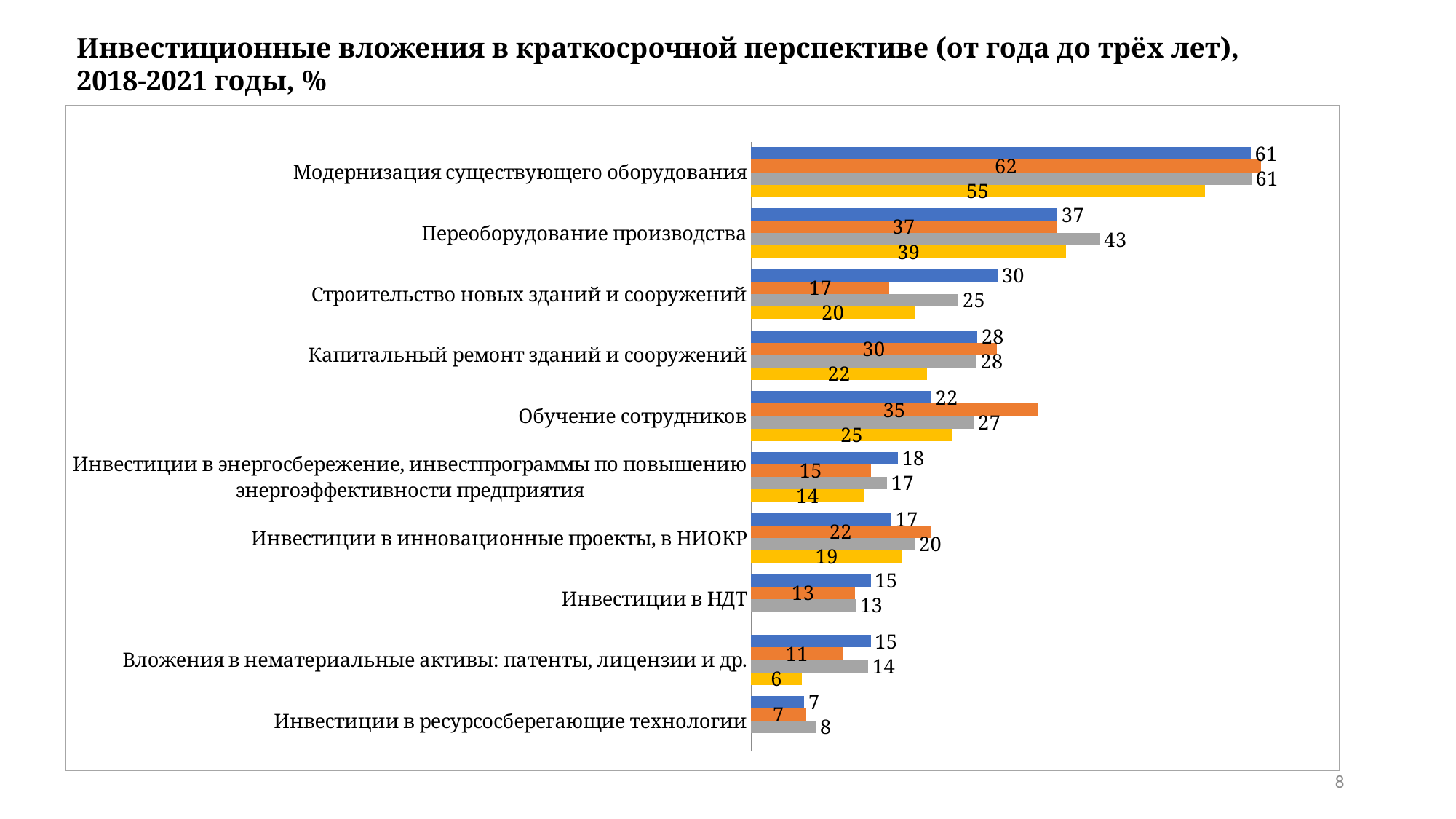
Which category has the lowest grey bar? Инвестиции в ресурсосберегающие технологии What is the value of the yellow bar for 'Переоборудование производства'? 39 What is the value of the orange bar for 'Модернизация существующего оборудования'? 62 What is the value of the grey bar for 'Обучение сотрудников'? 27 For 'Модернизация существующего оборудования', what is the difference between the blue bar and the yellow bar? 6 What is the value of the blue bar for 'Инвестиции в энергосбережение, инвестпрограммы по повышению энергоэффективности предприятия'? 18 How many categories are listed on the vertical axis of the chart? 10 For 'Переоборудование производства', what is the difference between the grey bar and the blue bar? 6 Which category has the highest blue bar? Модернизация существующего оборудования How many differently coloured bars are shown for 'Модернизация существующего оборудования'? 4 Which has the larger blue bar: 'Строительство новых зданий и сооружений' or 'Капитальный ремонт зданий и сооружений'? Строительство новых зданий и сооружений What kind of chart is shown on the slide? bar chart